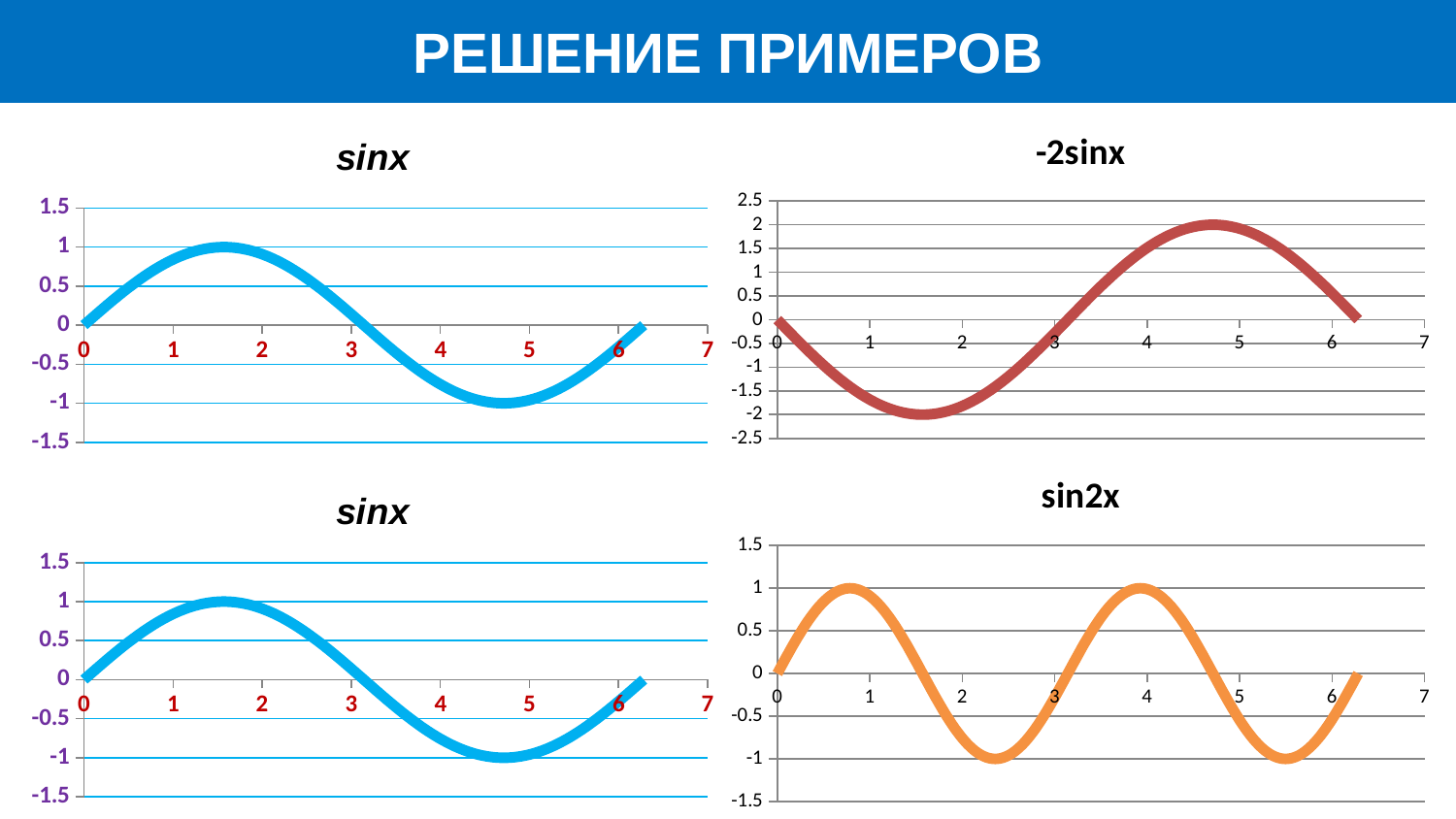
In the "sin2x" chart, is the value at x = 1 greater or less than 0.5? greater In the bottom-left "sinx" chart, does the line rise or fall between x = 2 and x = 4? fall How many charts are shown on the slide? 4 What kind of chart is the top-left chart titled "sinx"? line chart In the top-left "sinx" chart, is the value at x = 4 greater or less than -0.5? less In the "sin2x" chart, is the value at x = 2 greater or less than -0.5? less What colour is the line in the "sin2x" chart? orange In the "-2sinx" chart, does the line rise or fall between x = 2 and x = 4? rise In the "-2sinx" chart, which is larger: the value at x = 1 or the value at x = 5? x = 5